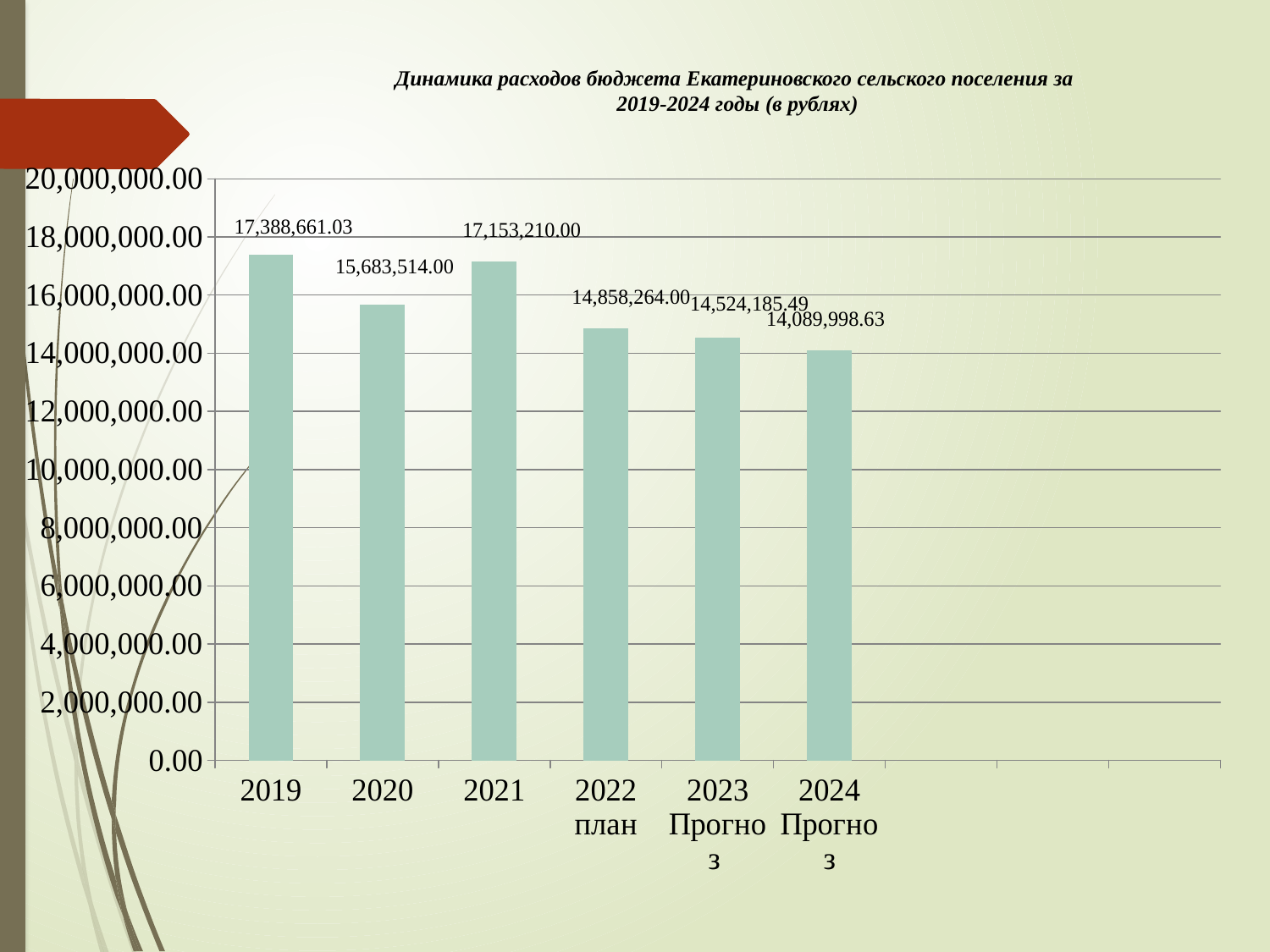
Which year has the lowest value? 2024 Прогноз What is the difference between the values for 2019 and 2020? 1,705,147.03 What is the value for 2019? 17,388,661.03 Do the values rise or fall from 2021 to 2024? fall Which year has the highest value? 2019 What is the difference between the values for 2021 and 2022 план? 2,294,946.00 What kind of chart is shown on the slide? bar chart Which is larger, the value for 2020 or the value for 2021? 2021 Is the value for 2023 Прогноз greater or less than 16,000,000.00? less How many bars are shown in the chart? 6 What is the value for 2022 план? 14,858,264.00 What is the value for 2024 Прогноз? 14,089,998.63